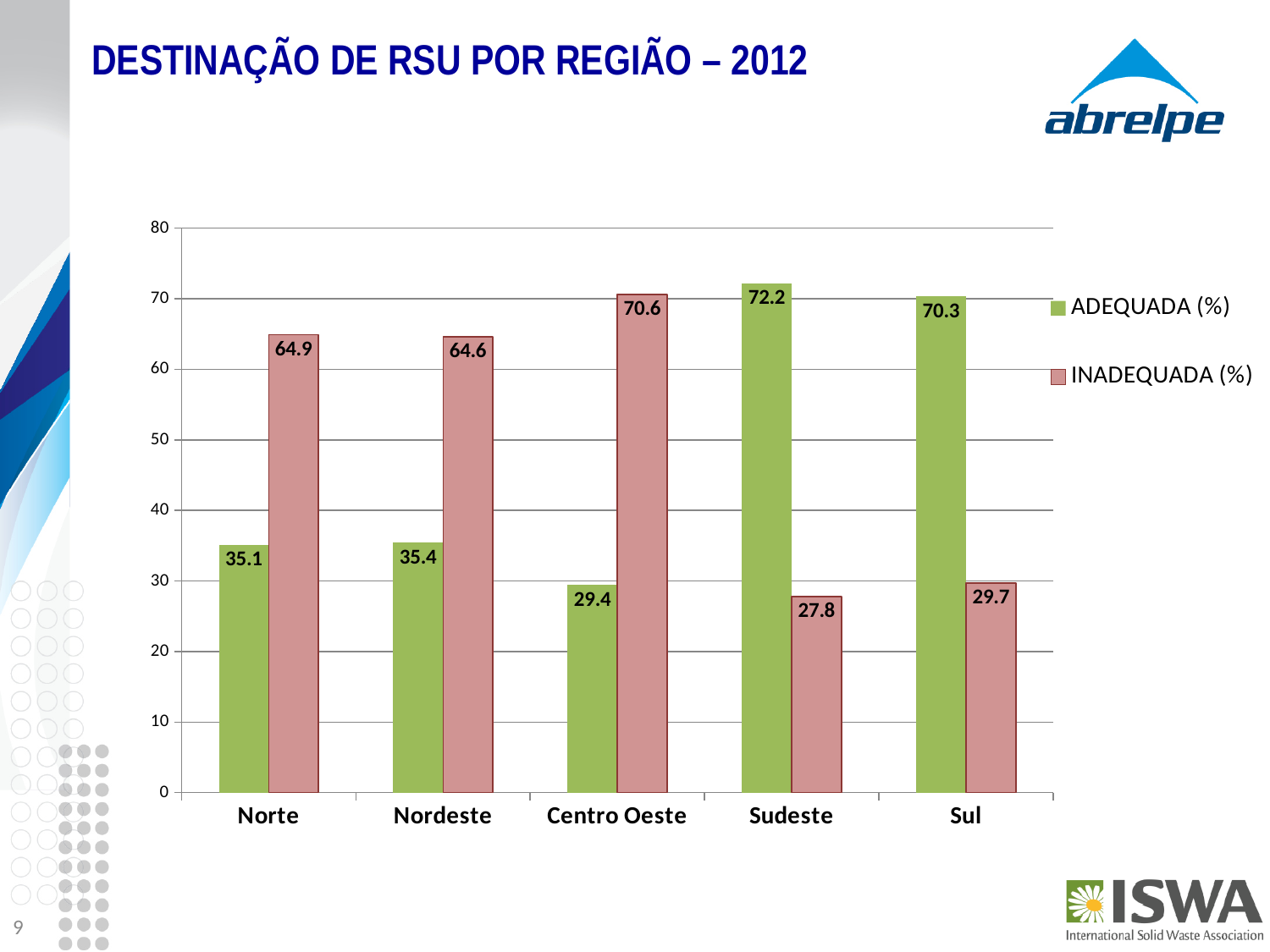
What colour are the ADEQUADA (%) bars? Green Which is larger for Sul: ADEQUADA (%) or INADEQUADA (%)? ADEQUADA (%) Is the INADEQUADA (%) value for Norte greater or less than 60? greater How many series does the legend list? 2 What is the difference between the INADEQUADA (%) and ADEQUADA (%) values for Nordeste? 29.2 How many regions are shown on the x axis? 5 Which region has the highest ADEQUADA (%) value? Sudeste What is the ADEQUADA (%) value for Sudeste? 72.2 What is the ADEQUADA (%) value for Norte? 35.1 What is the INADEQUADA (%) value for Centro Oeste? 70.6 Which region has the lowest INADEQUADA (%) value? Sudeste What kind of chart is shown on the slide? Bar chart